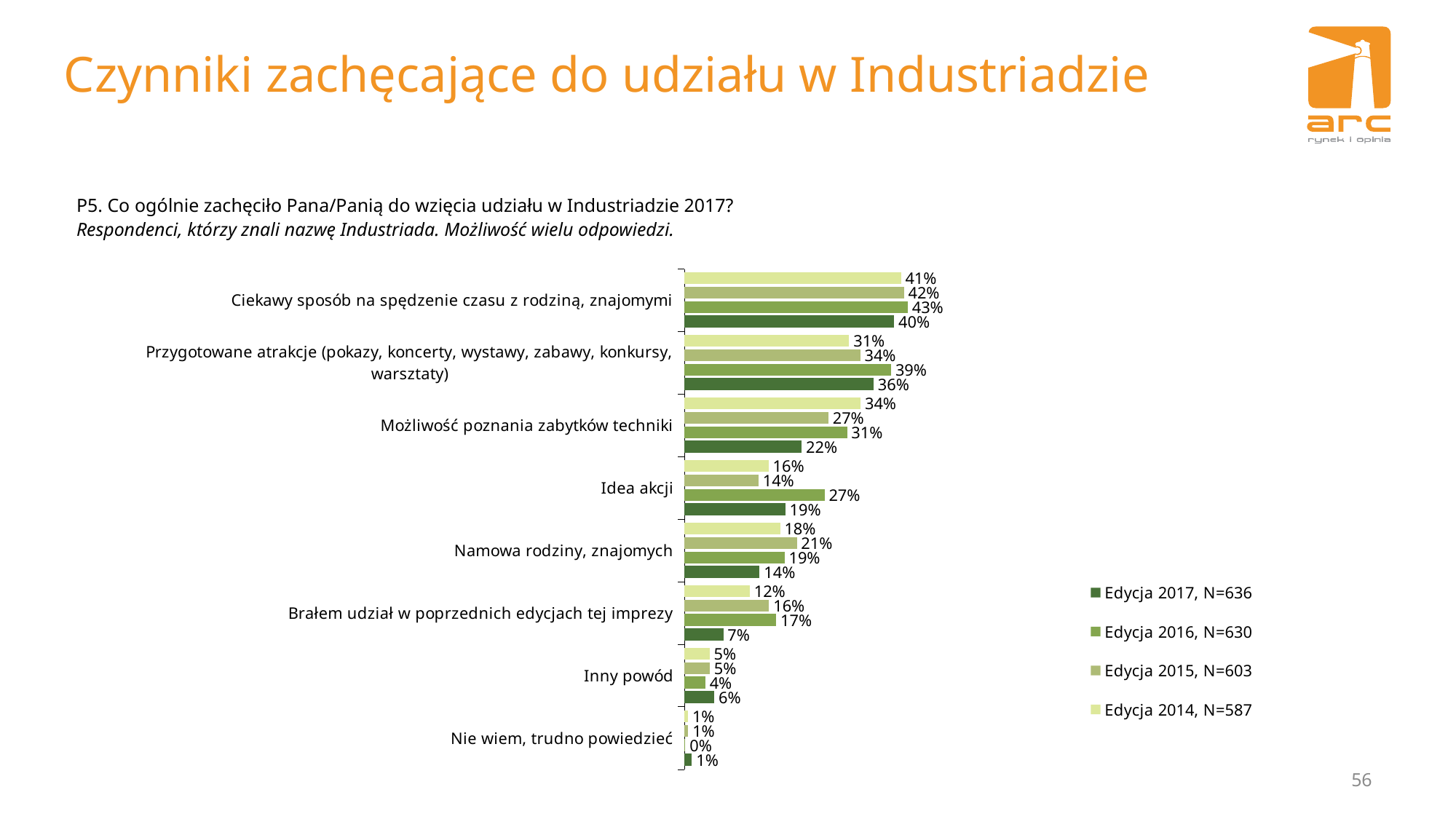
Which category has the lowest value in the Edycja 2016, N=630 series? Nie wiem, trudno powiedzieć What is the difference between the Edycja 2016, N=630 and Edycja 2017, N=636 values for "Brałem udział w poprzednich edycjach tej imprezy"? 10% What is the value for "Możliwość poznania zabytków techniki" in the Edycja 2014, N=587 series? 34% Which category has the highest value in the Edycja 2017, N=636 series? Ciekawy sposób na spędzenie czasu z rodziną, znajomymi What is the value for "Idea akcji" in the Edycja 2016, N=630 series? 27% How many categories are shown on the chart? 8 What kind of chart is shown on the slide? bar chart What is the value for "Ciekawy sposób na spędzenie czasu z rodziną, znajomymi" in the Edycja 2017, N=636 series? 40% How many series does the legend list? 4 What is the value for "Namowa rodziny, znajomych" in the Edycja 2015, N=603 series? 21% What is the sample size (N) given in the legend for Edycja 2015? 603 For "Przygotowane atrakcje (pokazy, koncerty, wystawy, zabawy, konkursy, warsztaty)", which is larger: the Edycja 2016, N=630 value or the Edycja 2014, N=587 value? Edycja 2016, N=630